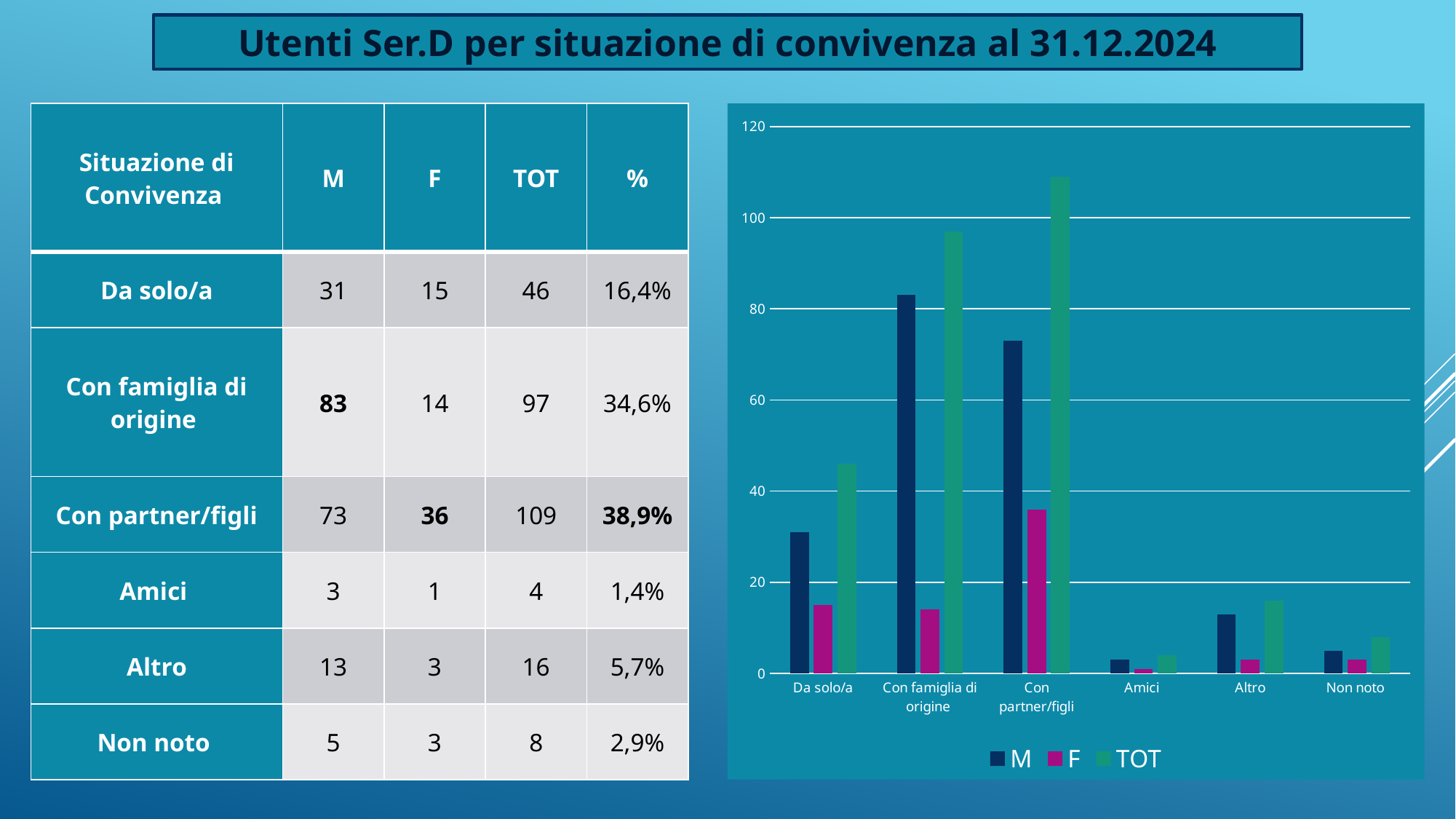
Which category has the highest TOT value in the chart? Con partner/figli Which category has the lowest TOT value in the chart? Amici How many series does the chart legend list? 3 Which category has the highest M value in the chart? Con famiglia di origine What are the three series listed in the chart legend? M, F, TOT What is the TOT value for Con famiglia di origine? 97 Is the M value for Con famiglia di origine greater or less than 80? greater Is the F value for Con partner/figli greater or less than 40? less Is the TOT value for Con partner/figli greater or less than 100? greater Which is larger in the chart: the M value for Da solo/a or the M value for Altro? Da solo/a How many categories are shown on the x axis of the chart? 6 What kind of chart is shown on the slide? bar chart